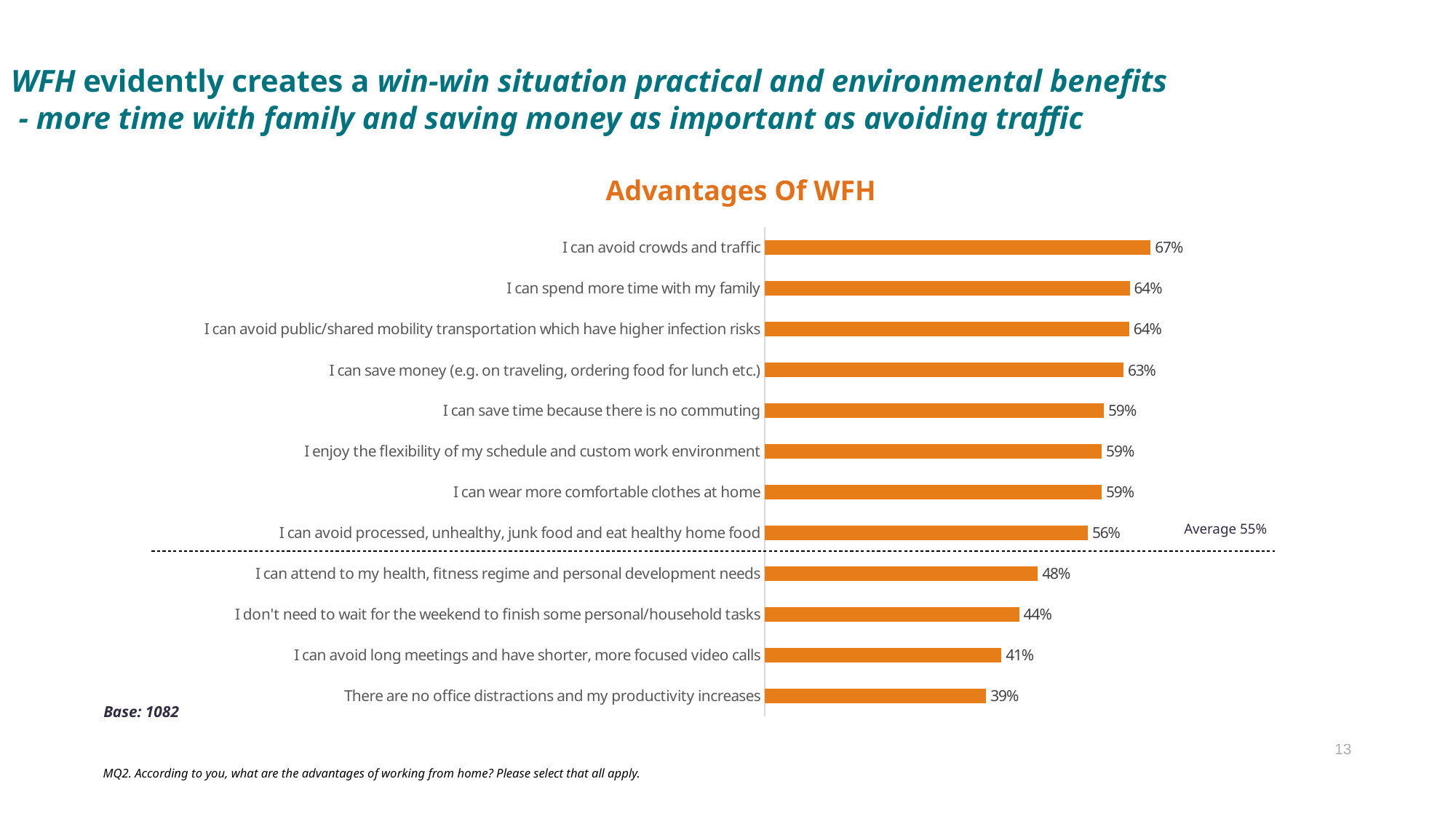
How many advantages of WFH are listed in the chart? 12 What is the difference between the values for "I can avoid crowds and traffic" and "I can spend more time with my family"? 3% What kind of chart is shown on the slide? Bar chart What percentage of respondents said "I can avoid crowds and traffic" is an advantage of WFH? 67% What is the title of the chart? Advantages Of WFH What average value is indicated by the dashed line on the chart? 55% Which advantage of WFH has the highest percentage? I can avoid crowds and traffic What is the value for "There are no office distractions and my productivity increases"? 39% What is the value for "I can save money (e.g. on traveling, ordering food for lunch etc.)"? 63% Which advantage of WFH has the lowest percentage? There are no office distractions and my productivity increases Which is larger: the value for "I can avoid processed, unhealthy, junk food and eat healthy home food" or for "I don't need to wait for the weekend to finish some personal/household tasks"? I can avoid processed, unhealthy, junk food and eat healthy home food What is the difference between "I can attend to my health, fitness regime and personal development needs" and "I can avoid long meetings and have shorter, more focused video calls"? 7%